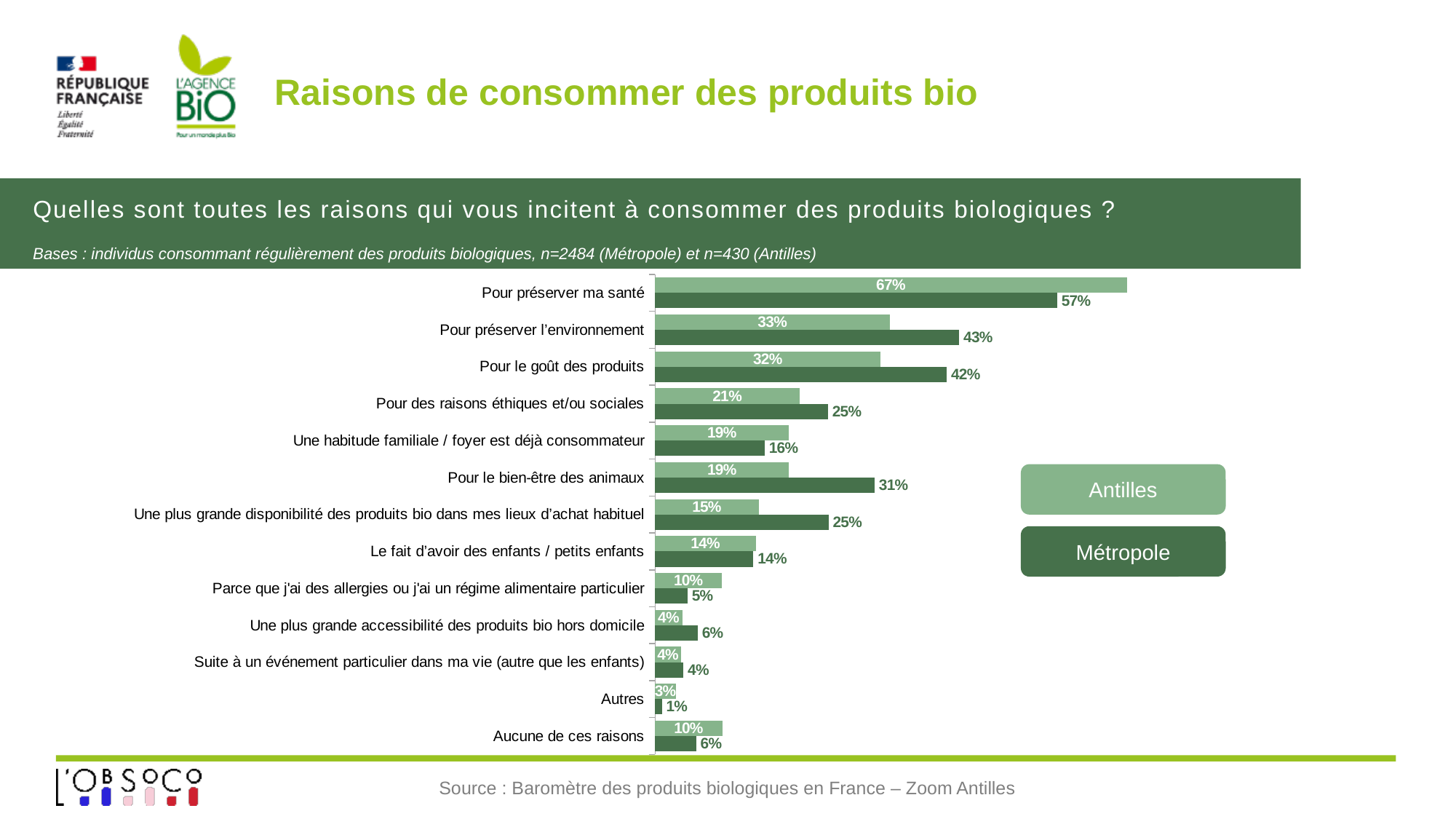
How many series does the legend list? 2 What is the Métropole value for "Pour préserver l'environnement"? 43% What is the difference between the Antilles and Métropole values for "Pour préserver ma santé"? 10% For "Pour des raisons éthiques et/ou sociales", which is larger: the Antilles value or the Métropole value? Métropole What is the difference between the Métropole and Antilles values for "Pour le goût des produits"? 10% Which category has the lowest Métropole value? Autres Which category has the highest Antilles value? Pour préserver ma santé What is the Antilles value for "Pour préserver ma santé"? 67% How many categories are shown in the chart? 13 What is the Métropole value for "Pour le bien-être des animaux"? 31% What kind of chart is shown on the slide? Bar chart For "Parce que j'ai des allergies ou j'ai un régime alimentaire particulier", which is larger: the Antilles value or the Métropole value? Antilles